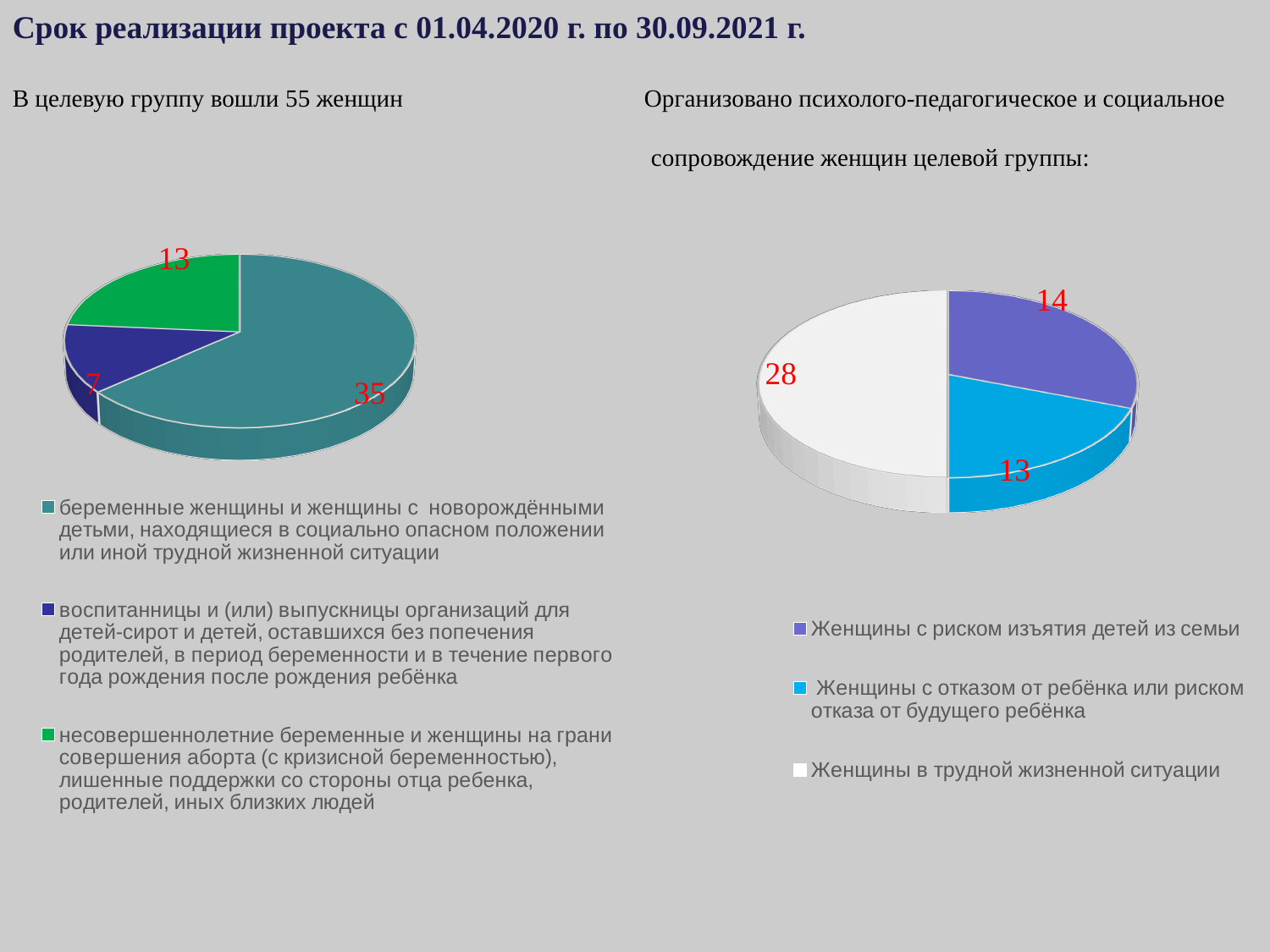
How many slices does the left pie chart have? 3 In the right pie chart, what is the difference between 'Женщины в трудной жизненной ситуации' (28) and 'Женщины с риском изъятия детей из семьи' (14)? 14 In the right pie chart, what share of the total do 'Женщины с риском изъятия детей из семьи' (14 out of 14+13+28) represent, as a percentage rounded to the nearest whole number? 25% In the right pie chart, what is the value for 'Женщины с отказом от ребёнка или риском отказа от будущего ребёнка'? 13 In the left pie chart, what is the value for 'воспитанницы и (или) выпускницы организаций для детей-сирот и детей, оставшихся без попечения родителей'? 7 In the right pie chart, which category has the largest value? Женщины в трудной жизненной ситуации How many entries does the legend of the right pie chart list? 3 In the left pie chart, what is the value for the slice 'беременные женщины и женщины с новорождёнными детьми, находящиеся в социально опасном положении или иной трудной жизненной ситуации'? 35 In the left pie chart, which category has the smallest value? воспитанницы и (или) выпускницы организаций для детей-сирот и детей, оставшихся без попечения родителей In the right pie chart, what is the value for 'Женщины в трудной жизненной ситуации'? 28 In the left pie chart, what is the difference between the largest slice (35) and the slice for 'несовершеннолетние беременные и женщины на грани совершения аборта' (13)? 22 What type of chart is shown on the left side of the slide? pie chart